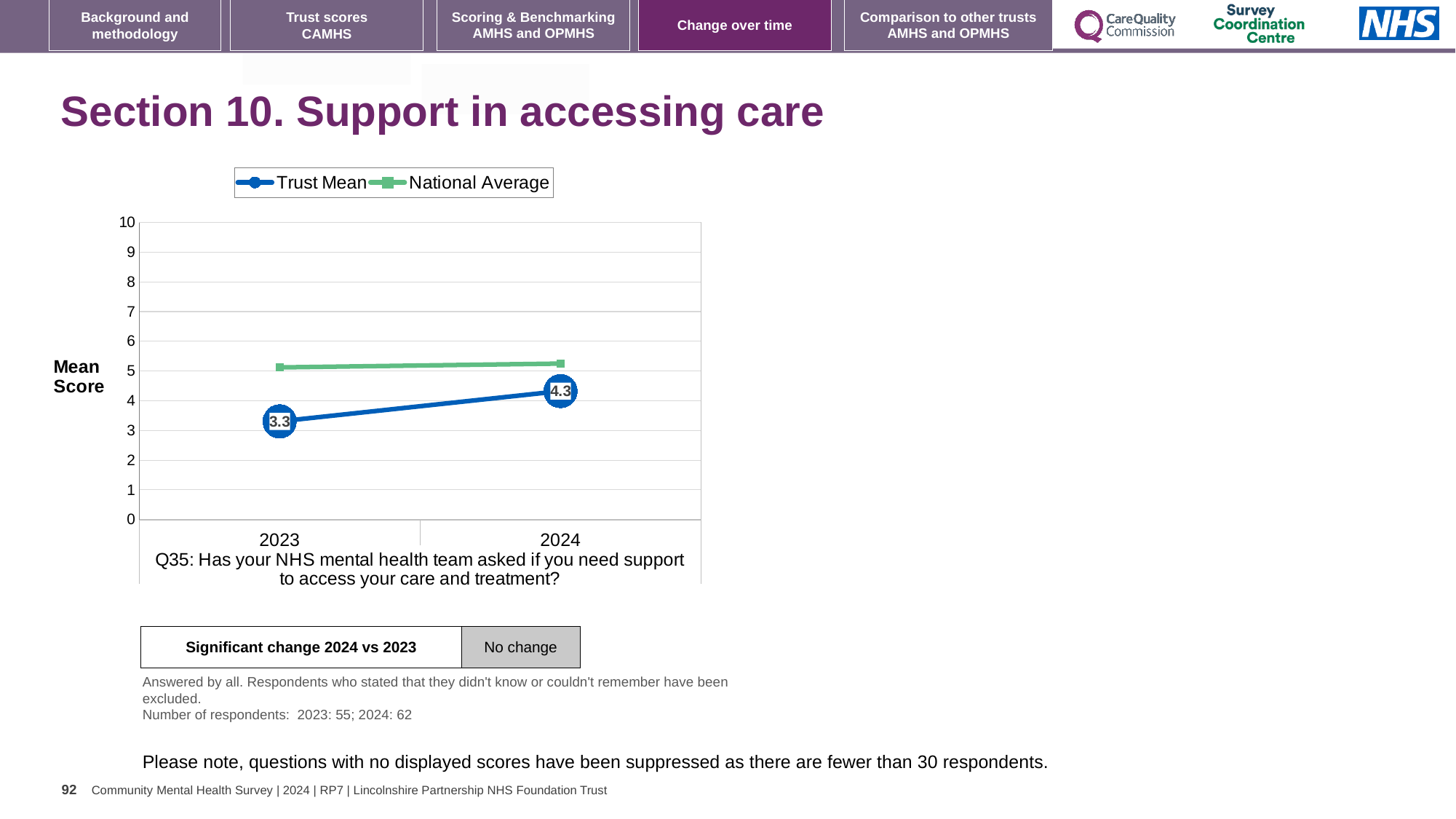
Is the National Average value for 2023 greater or less than 4? greater In which year is the Trust Mean lower? 2023 What is the Trust Mean score for 2023? 3.3 What kind of chart is shown on the slide? line chart What is the Trust Mean score for 2024? 4.3 In 2024, which is higher: the Trust Mean or the National Average? National Average Is the National Average value for 2024 greater or less than 6? less Does the Trust Mean rise or fall from 2023 to 2024? rise In which year is the Trust Mean higher, 2023 or 2024? 2024 By how much did the Trust Mean change from 2023 to 2024? 1.0 How many series does the legend list? 2 How many years are plotted on the x axis? 2